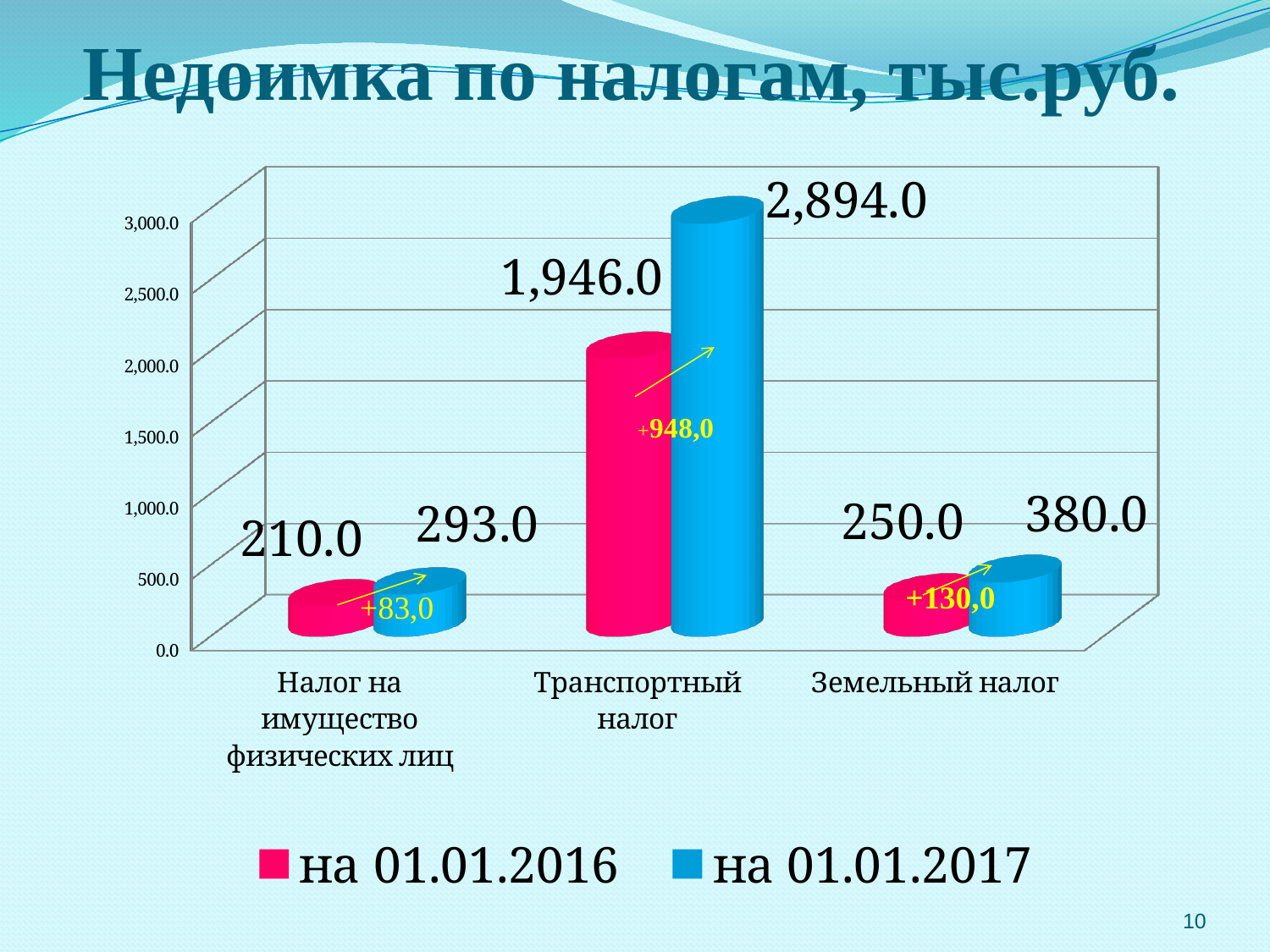
What is the value for Земельный налог in the series на 01.01.2017? 380.0 How many categories are shown on the x axis? 3 What is the value for Транспортный налог in the series на 01.01.2017? 2,894.0 What is the difference between the на 01.01.2017 and на 01.01.2016 values for Транспортный налог? 948.0 Which is larger: the на 01.01.2016 value for Земельный налог or the на 01.01.2016 value for Налог на имущество физических лиц? Земельный налог Which category has the highest value in the series на 01.01.2016? Транспортный налог What is the difference between the на 01.01.2017 and на 01.01.2016 values for Земельный налог? 130.0 What kind of chart is shown on the slide? Bar chart What is the value for Налог на имущество физических лиц in the series на 01.01.2016? 210.0 Which category has the lowest value in the series на 01.01.2017? Налог на имущество физических лиц What is the title of the chart? Недоимка по налогам, тыс.руб. How many series does the legend list? 2